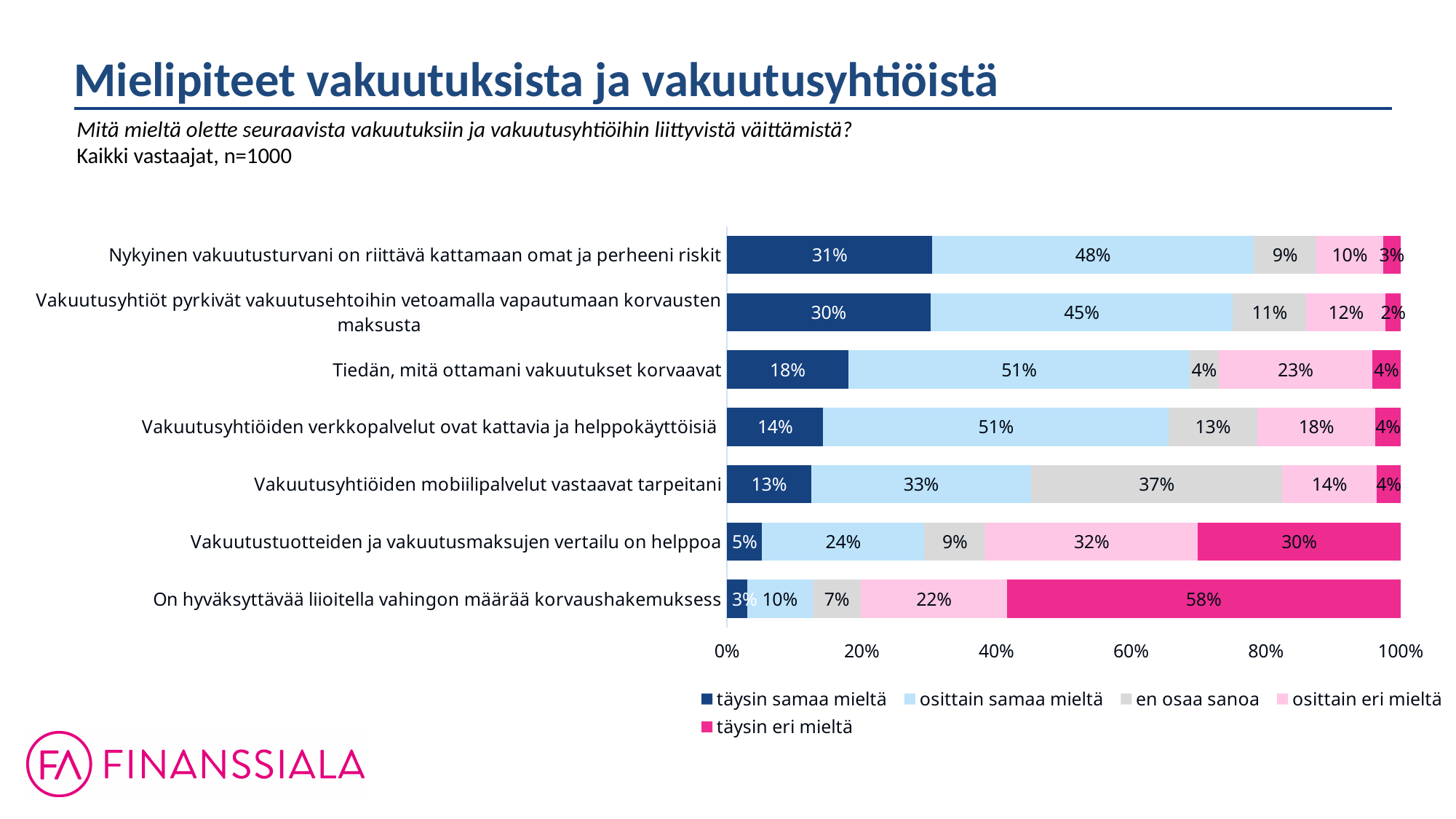
What kind of chart is shown on the slide? Stacked bar chart How many series does the legend list? 5 What is the 'osittain eri mieltä' value for 'Vakuutustuotteiden ja vakuutusmaksujen vertailu on helppoa'? 32% What is the 'täysin samaa mieltä' value for 'Nykyinen vakuutusturvani on riittävä kattamaan omat ja perheeni riskit'? 31% What is the 'en osaa sanoa' value for 'Vakuutusyhtiöiden mobiilipalvelut vastaavat tarpeitani'? 37% What is the 'täysin eri mieltä' value for 'On hyväksyttävää liioitella vahingon määrää korvaushakemuksessa'? 58% How many statements (categories) are plotted in the chart? 7 Which is larger: the 'osittain samaa mieltä' value for 'Tiedän, mitä ottamani vakuutukset korvaavat' or for 'Vakuutusyhtiöiden mobiilipalvelut vastaavat tarpeitani'? Tiedän, mitä ottamani vakuutukset korvaavat Which statement has the lowest 'täysin samaa mieltä' share? On hyväksyttävää liioitella vahingon määrää korvaushakemuksessa Which legend entry is shown in the darkest blue colour? täysin samaa mieltä What is the difference in 'täysin eri mieltä' between 'On hyväksyttävää liioitella vahingon määrää korvaushakemuksessa' and 'Vakuutustuotteiden ja vakuutusmaksujen vertailu on helppoa'? 28 percentage points Which statement has the highest 'täysin eri mieltä' share? On hyväksyttävää liioitella vahingon määrää korvaushakemuksessa